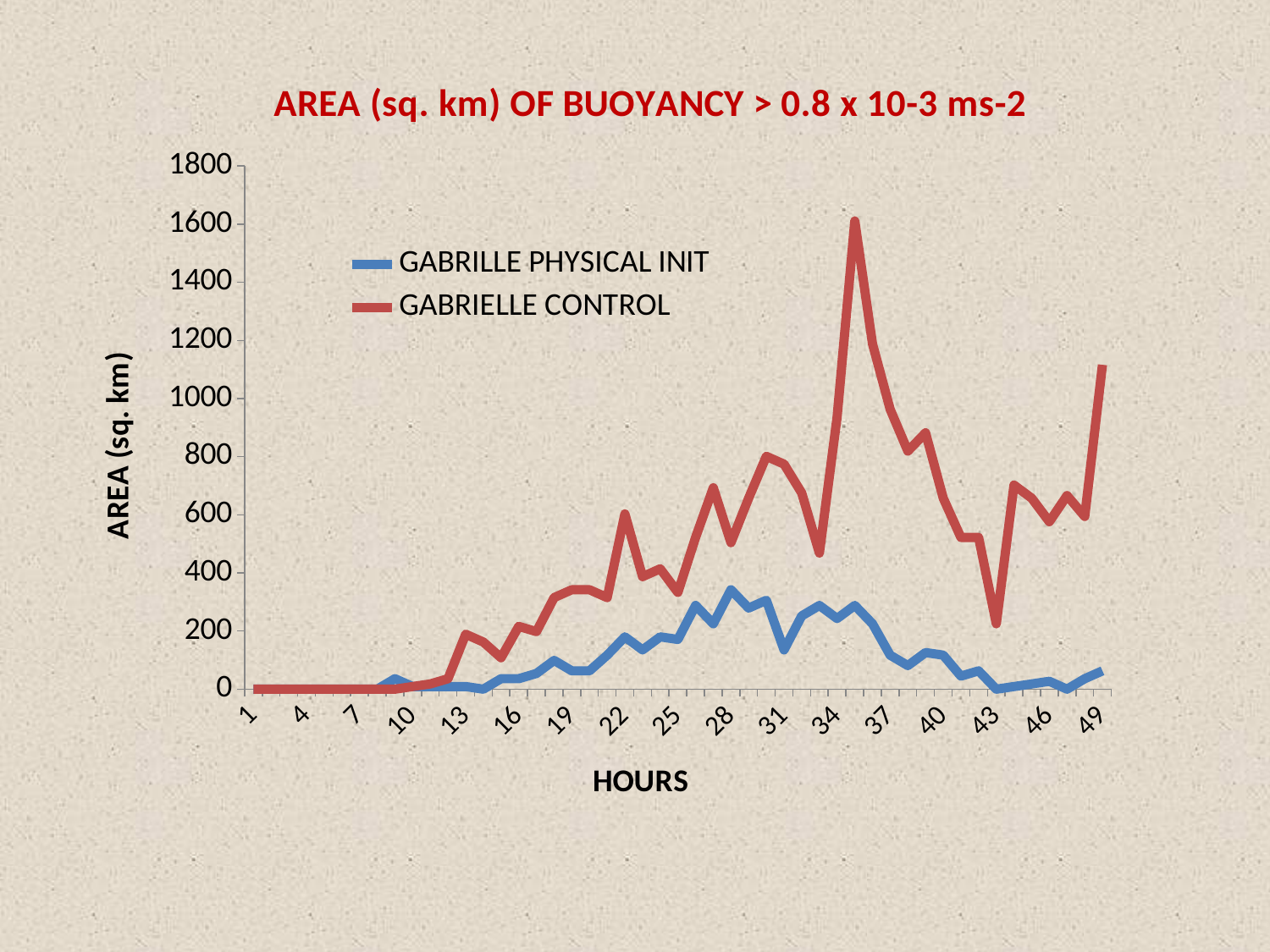
How many series does the legend list? 2 Which series reaches the highest value on the chart? GABRIELLE CONTROL Is the value for GABRILLE PHYSICAL INIT at hour 49 greater or less than 200? less At hour 28, which series has the larger value, GABRIELLE CONTROL or GABRILLE PHYSICAL INIT? GABRIELLE CONTROL Does the GABRIELLE CONTROL series generally rise or fall between hour 1 and hour 22? rise Is the value for GABRIELLE CONTROL at hour 31 greater or less than 600? greater What is the title of the chart? AREA (sq. km) OF BUOYANCY > 0.8 x 10-3 ms-2 What kind of chart is shown on the slide? line chart Is the value for GABRIELLE CONTROL at hour 49 greater or less than 1000? greater What is the label of the x axis? HOURS